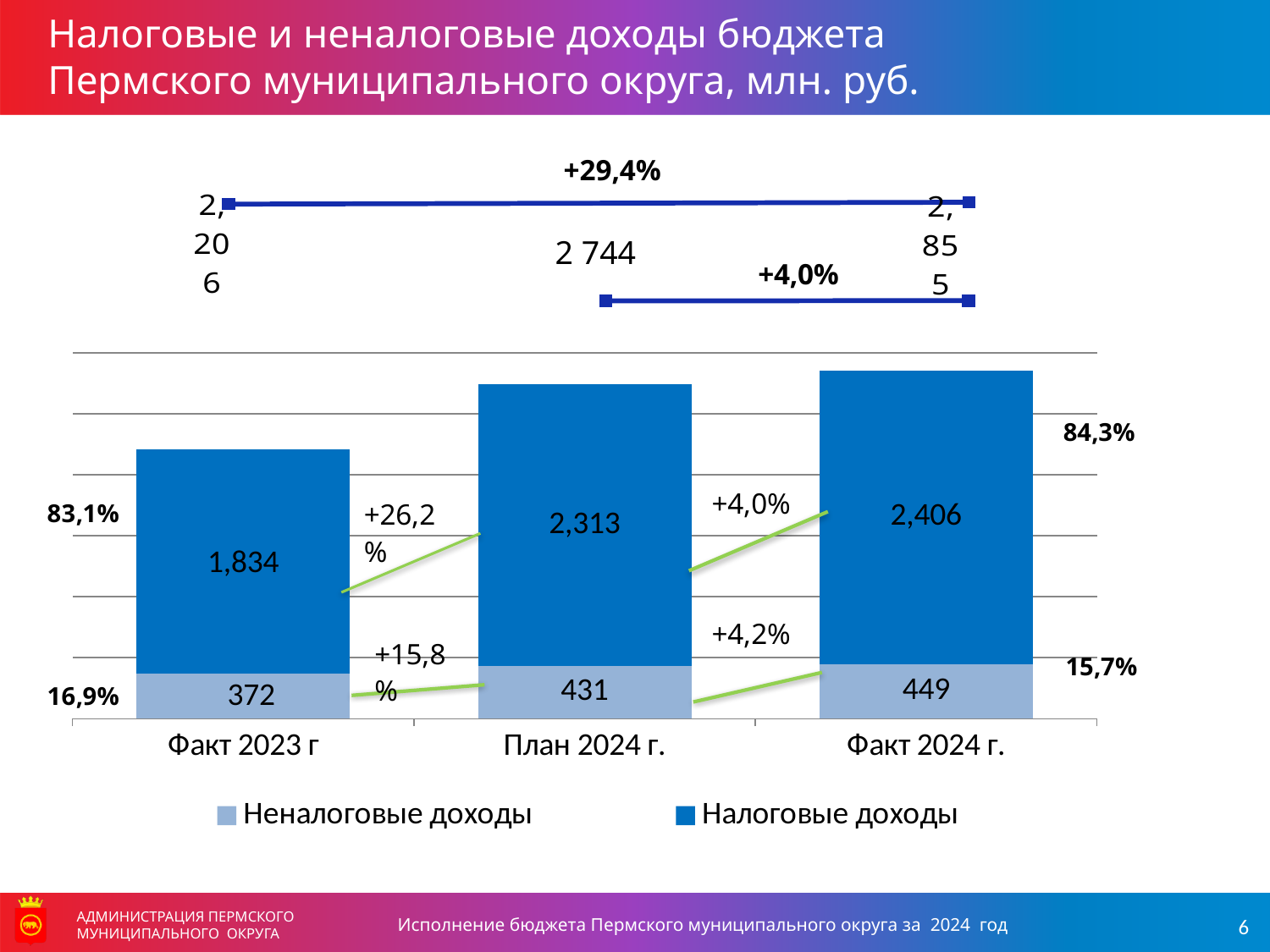
What is the value of Неналоговые доходы for План 2024 г.? 431 What kind of chart shows Налоговые доходы and Неналоговые доходы by year? Stacked bar chart Which category has the highest value of Неналоговые доходы? Факт 2024 г. Do the values of Налоговые доходы rise or fall from Факт 2023 г to Факт 2024 г.? Rise What is the value of Налоговые доходы for Факт 2023 г? 1,834 What is the difference between Налоговые доходы for Факт 2024 г. and План 2024 г.? 93 How many categories are shown on the x axis of the bar chart? 3 Which category has the lowest value of Налоговые доходы? Факт 2023 г What is the value of Налоговые доходы for Факт 2024 г.? 2,406 How many series does the legend of the bar chart list? 2 Which is larger: Неналоговые доходы for План 2024 г. or for Факт 2023 г? План 2024 г. What is the total of the stacked bar for Факт 2023 г? 2,206